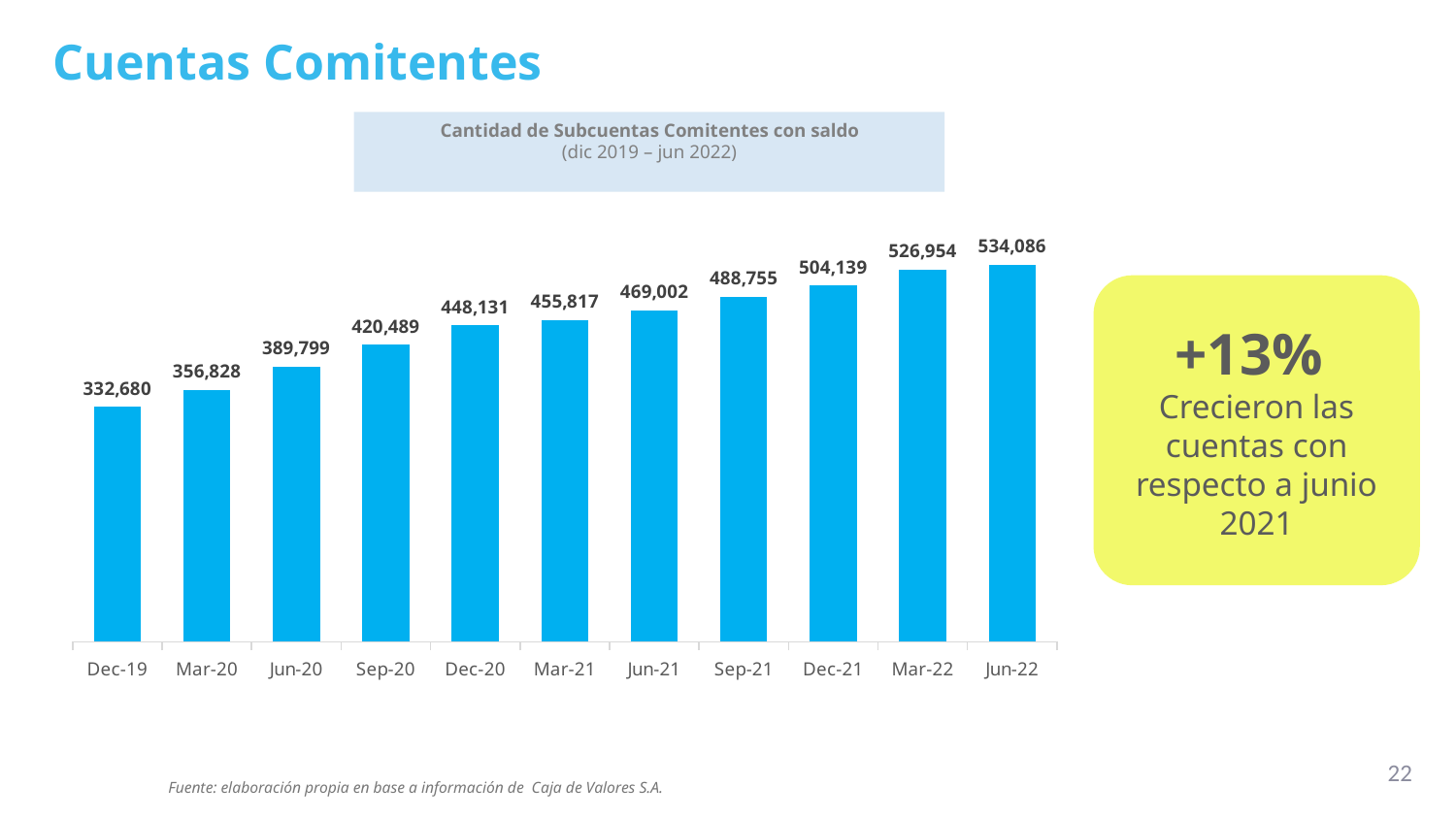
Which period has the lowest value? Dec-19 What is the title of the chart? Cantidad de Subcuentas Comitentes con saldo (dic 2019 – jun 2022) Which is larger, the value for Mar-21 or the value for Sep-20? Mar-21 What is the value for Jun-22? 534,086 What is the value for Sep-21? 488,755 Which period has the highest value? Jun-22 What kind of chart is shown? Bar chart How many periods are shown on the x axis? 11 Do the values rise or fall from Dec-19 to Jun-22? Rise What is the value for Dec-19? 332,680 What is the difference between the values for Jun-22 and Jun-21? 65,084 What is the difference between the values for Dec-21 and Dec-19? 171,459